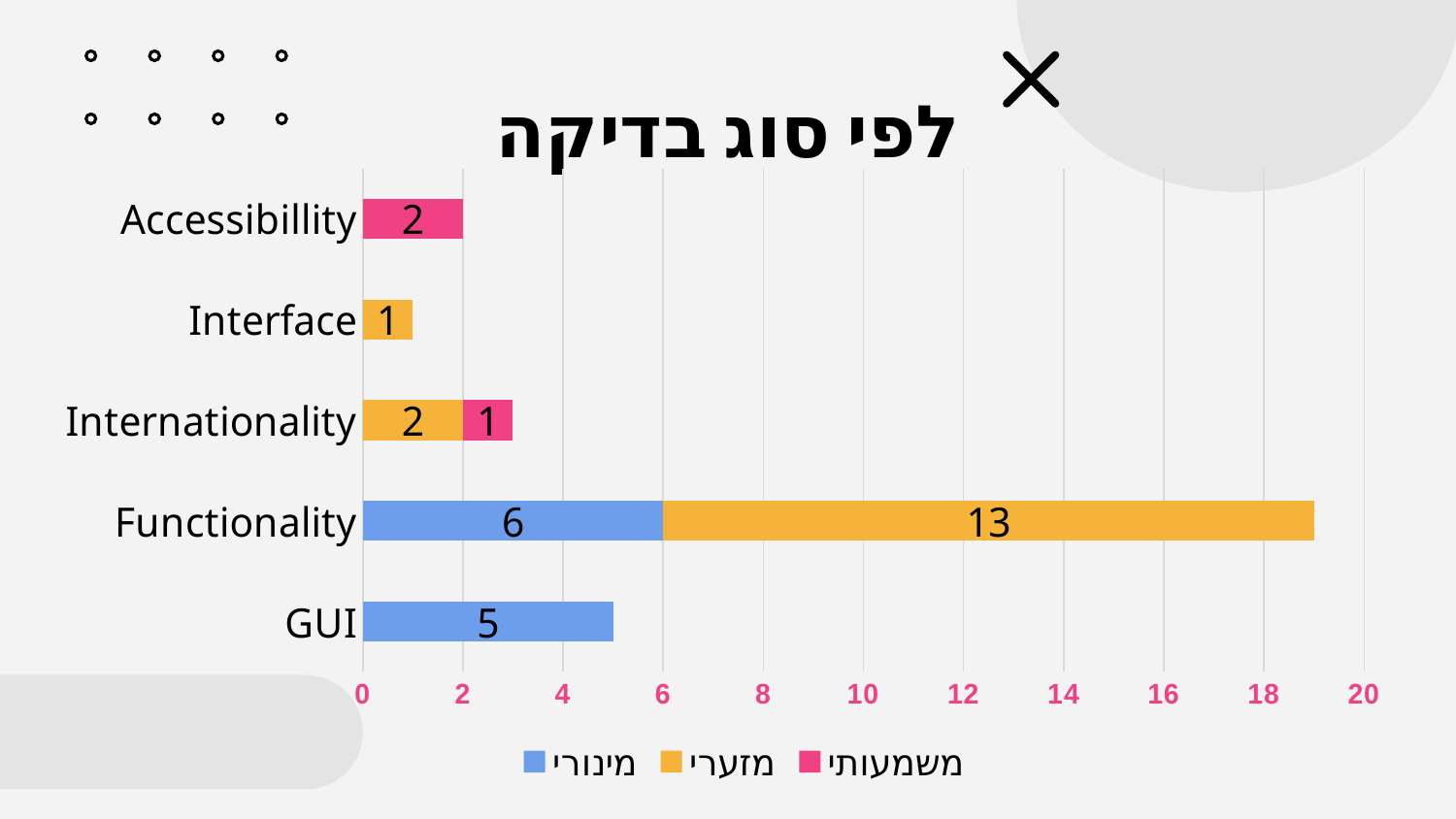
What is the total of the stacked bar for Internationality? 3 How many categories are shown on the chart? 5 What is the difference between the מזערי value and the מינורי value for Functionality? 7 What is the value of the משמעותי series for Accessibillity? 2 What is the value of the מינורי series for GUI? 5 What is the value of the מזערי series for Functionality? 13 What is the value of the מזערי series for Interface? 1 Which category has the shortest total bar? Interface Which category has the longest total bar? Functionality How many series does the legend list? 3 What is the total of the stacked bar for Functionality? 19 Which is larger: the מינורי value for Functionality or the מינורי value for GUI? Functionality